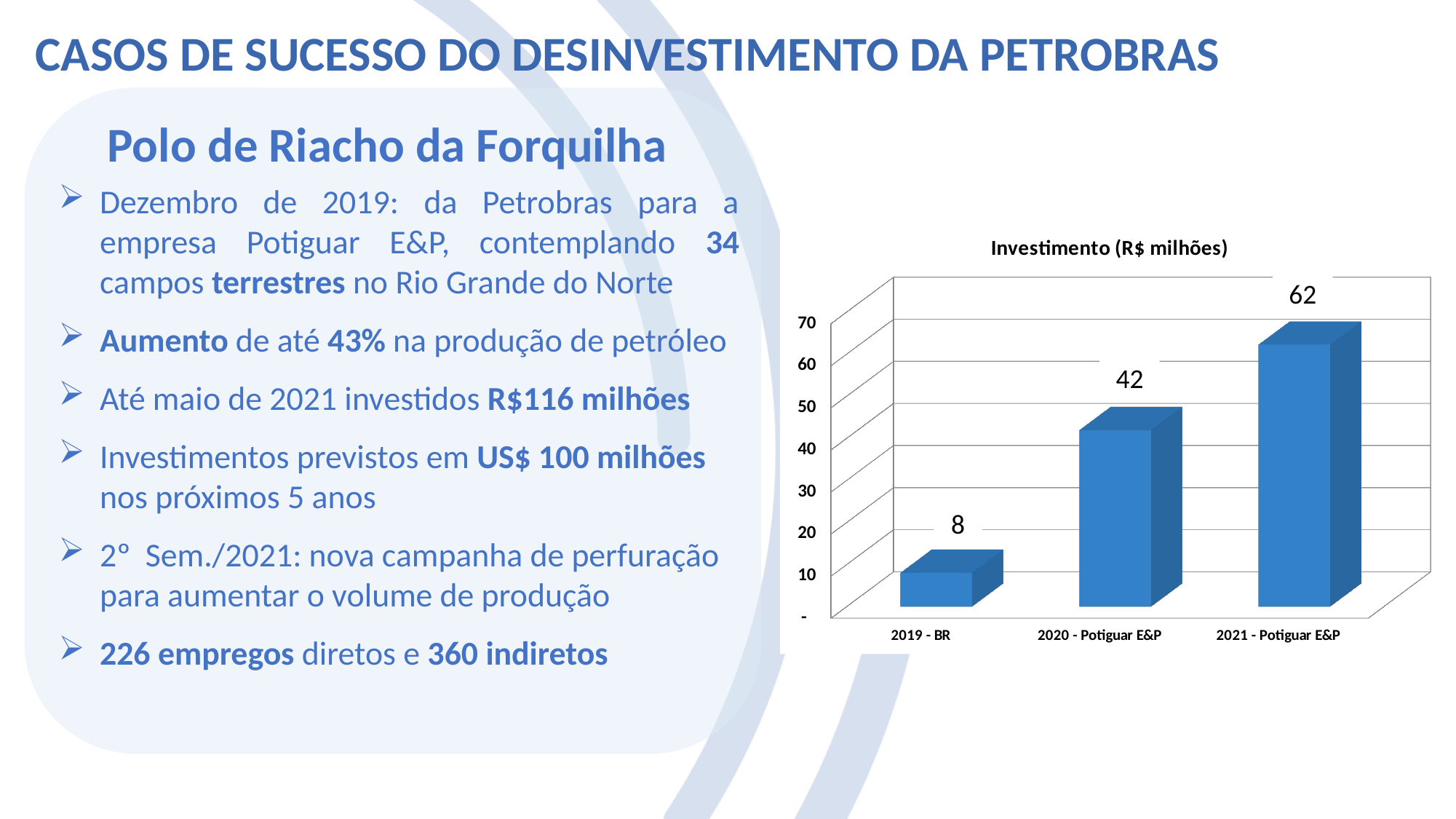
Which category has the highest value in the Investimento (R$ milhões) chart? 2021 - Potiguar E&P Is the value for 2021 - Potiguar E&P greater or less than 50? greater Which is larger, the value for 2020 - Potiguar E&P or the value for 2019 - BR? 2020 - Potiguar E&P How many categories are shown in the Investimento (R$ milhões) chart? 3 What is the value for 2021 - Potiguar E&P in the Investimento (R$ milhões) chart? 62 What is the difference between the values for 2021 - Potiguar E&P and 2020 - Potiguar E&P? 20 What kind of chart is shown on the slide? Bar chart What is the difference between the values for 2020 - Potiguar E&P and 2019 - BR? 34 What is the value for 2019 - BR in the Investimento (R$ milhões) chart? 8 Do the values rise or fall from 2019 - BR to 2021 - Potiguar E&P? Rise Which category has the lowest value in the Investimento (R$ milhões) chart? 2019 - BR What is the value for 2020 - Potiguar E&P in the Investimento (R$ milhões) chart? 42